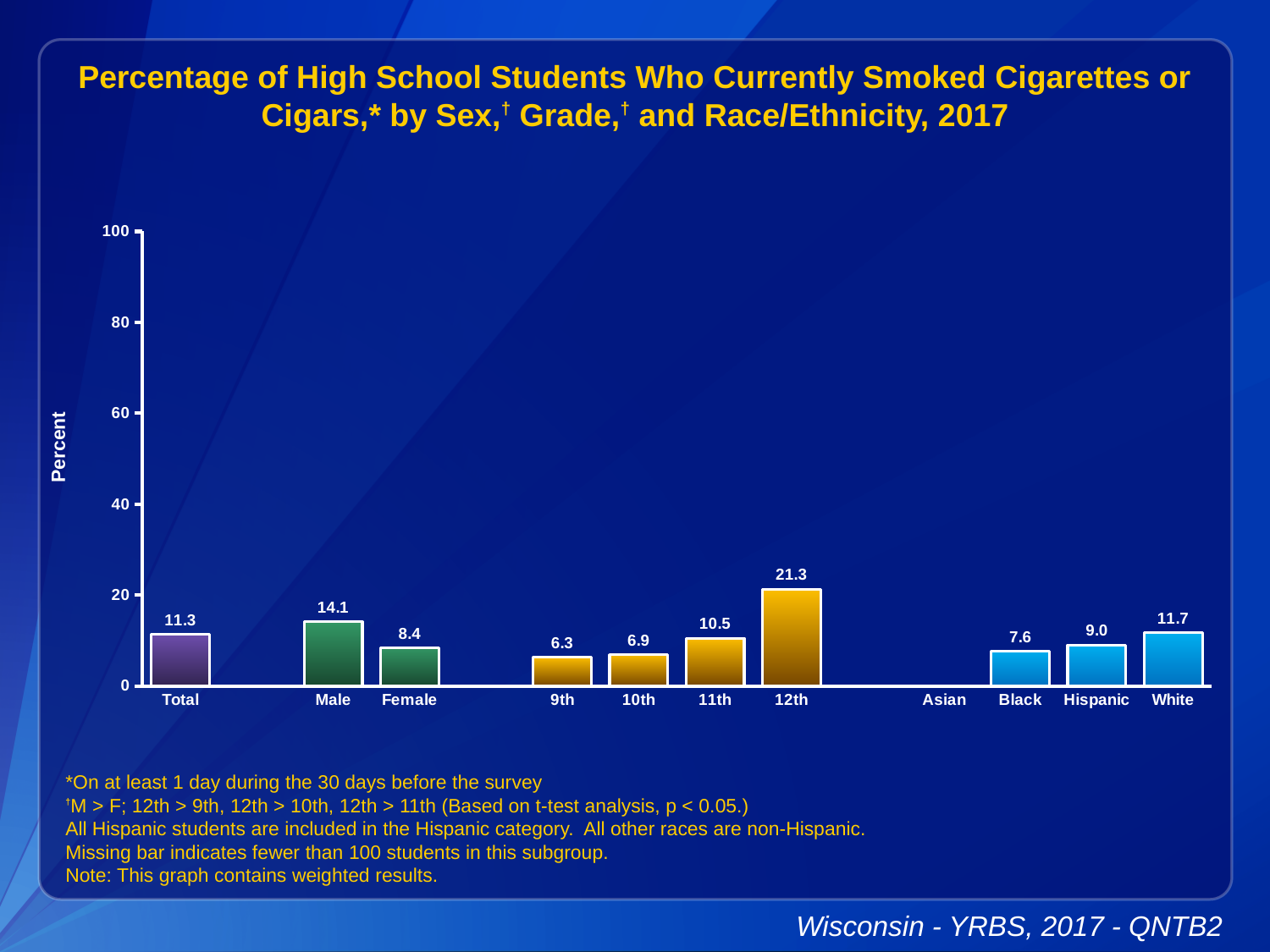
Which category on the x axis has no bar plotted? Asian What is the value for Total? 11.3 Is the value for 12th grade greater or less than 20? greater What is the value for Male? 14.1 What is the value for Hispanic? 9.0 What is the value for 12th grade? 21.3 Which category has the highest value? 12th How many categories are labeled on the x axis? 11 Which is larger, the value for Black or the value for White? White Which category with a plotted bar has the lowest value? 9th What is the difference between the Male and Female values? 5.7 What kind of chart is shown? bar chart